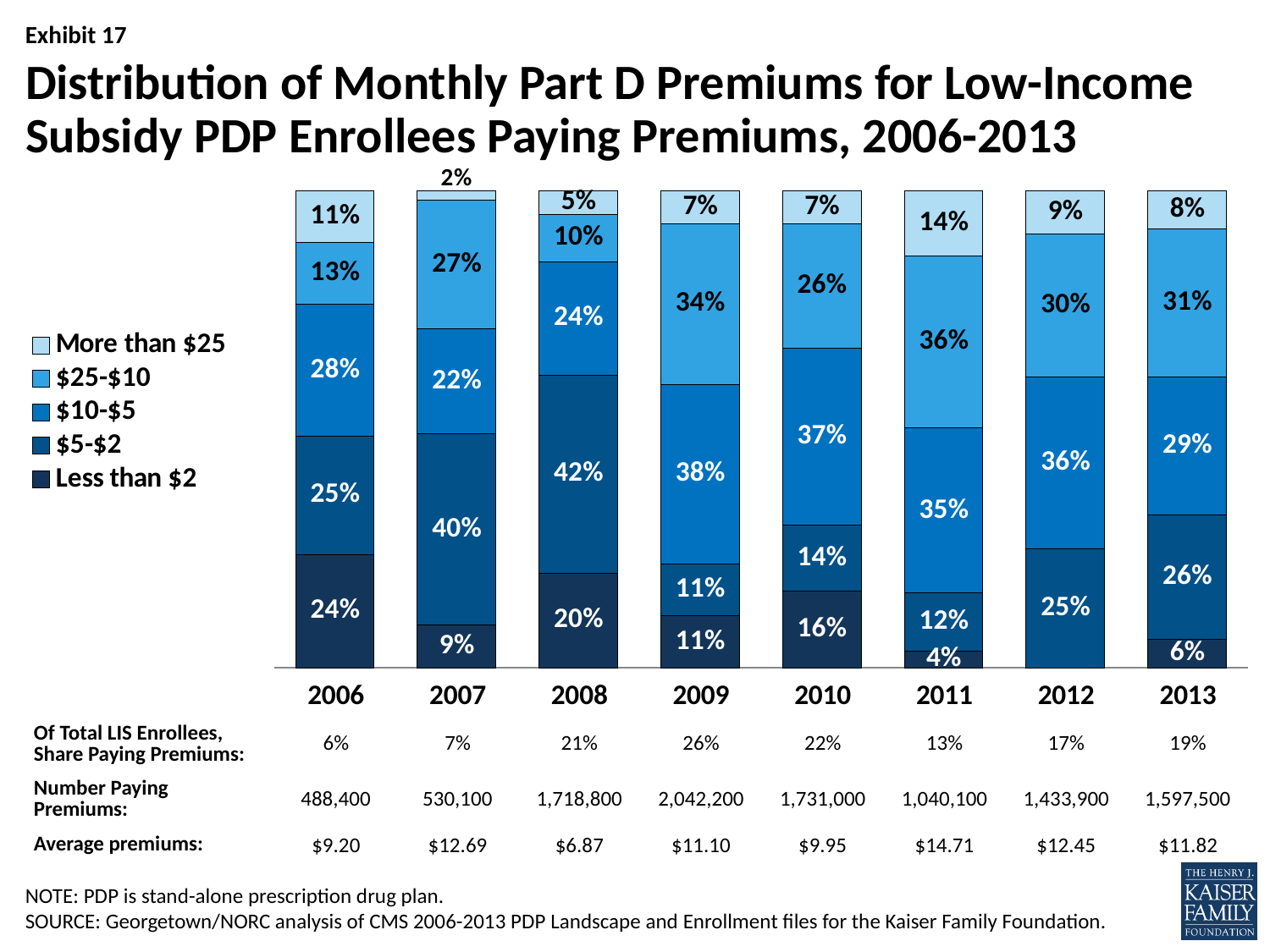
How many series does the legend list? 5 What share of LIS enrollees paying premiums paid less than $2 in 2006? 24% What share paid more than $25 in 2011? 14% By how many percentage points does the $10-$5 share in 2009 exceed the $10-$5 share in 2006? 10 percentage points What share paid $25-$10 in 2013? 31% In which year was the 'More than $25' share the largest? 2011 What share paid $10-$5 in 2010? 37% In which year was the 'Less than $2' share the smallest? 2012 What was the average premium in 2011 according to the table below the chart? $14.71 How many years are shown along the x axis? 8 What kind of chart is shown on the slide? Stacked bar chart Which year had the larger $5-$2 share, 2007 or 2008? 2008